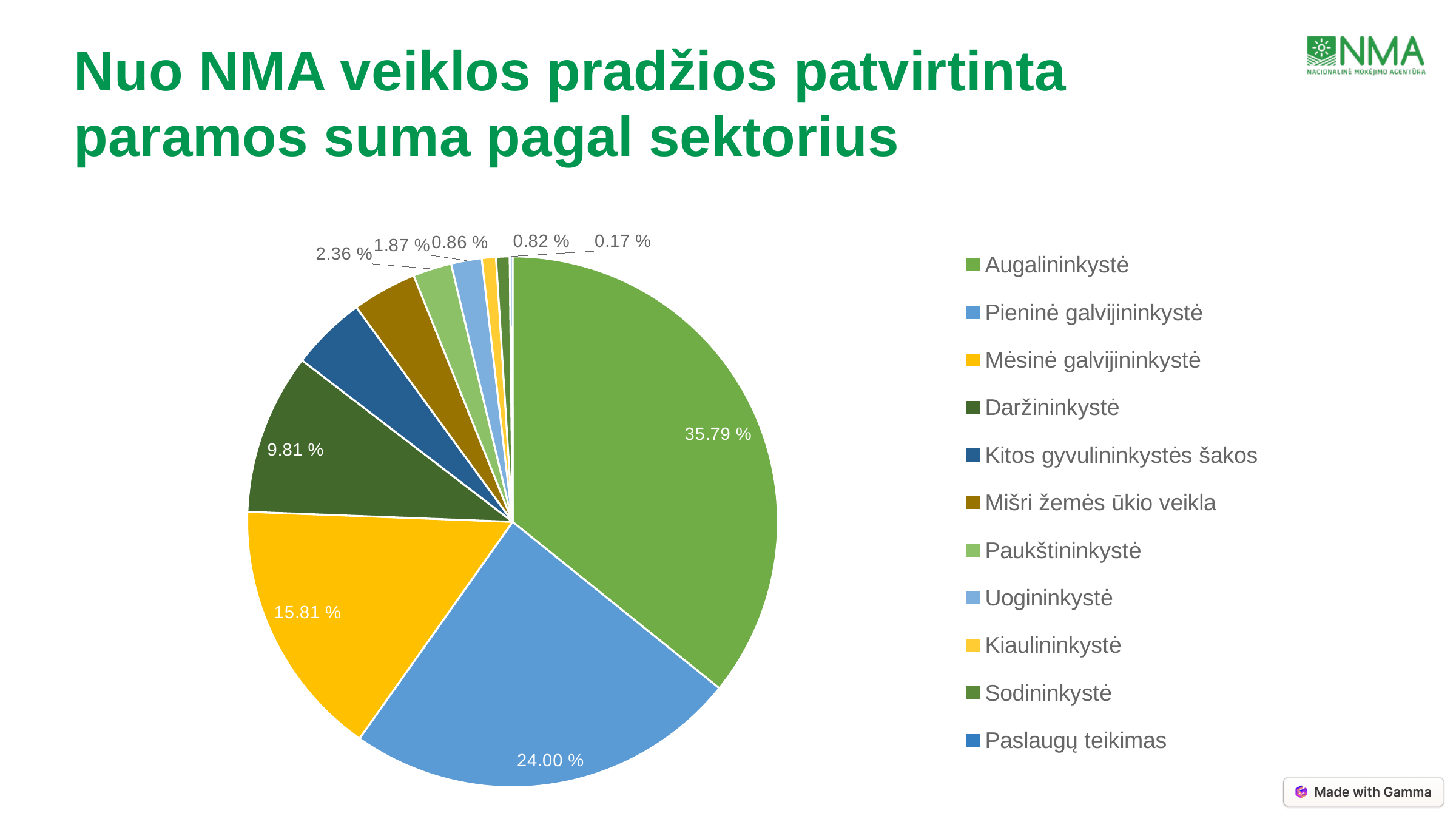
What is the value shown for Pieninė galvijininkystė? 24.00 % How many sectors are listed in the legend? 11 What is the value shown for Mėsinė galvijininkystė? 15.81 % What share of the pie does Augalininkystė have? 35.79 % What is the difference in percentage points between Augalininkystė and Pieninė galvijininkystė? 11.79 % What is the value shown for Paslaugų teikimas? 0.17 % What kind of chart is shown on the slide? pie chart Which sector has the smallest slice of the pie? Paslaugų teikimas What is the title of the slide containing the chart? Nuo NMA veiklos pradžios patvirtinta paramos suma pagal sektorius Which sector has the largest slice of the pie? Augalininkystė What is the value shown for Daržininkystė? 9.81 % Which is larger, Mėsinė galvijininkystė or Daržininkystė? Mėsinė galvijininkystė